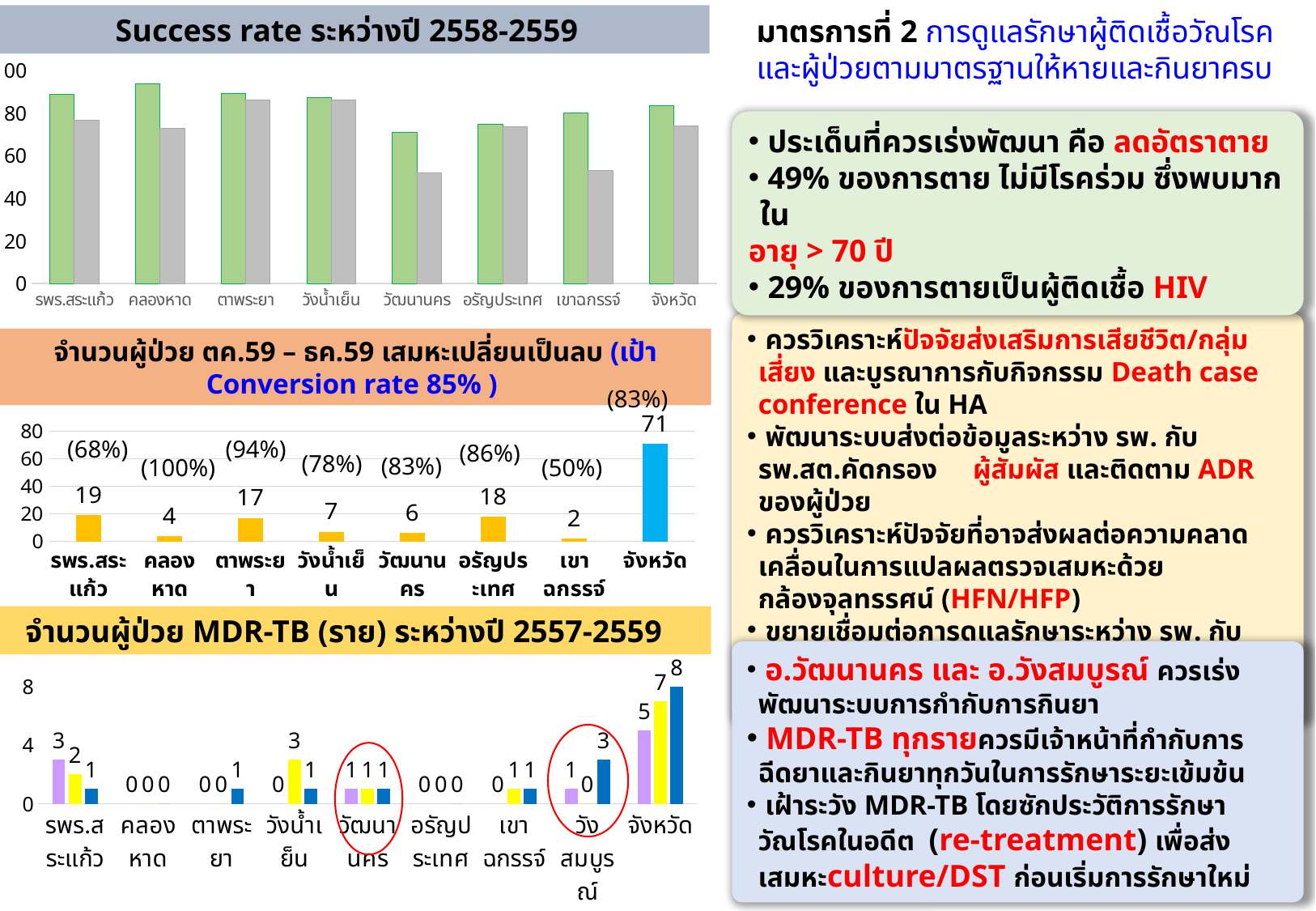
How many categories are shown on the x axis of the chart titled 'จำนวนผู้ป่วย MDR-TB (ราย) ระหว่างปี 2557-2559'? 9 In the chart titled 'จำนวนผู้ป่วย ตค.59 – ธค.59 เสมหะเปลี่ยนเป็นลบ', what is the value for ตาพระยา? 17 In the chart titled 'จำนวนผู้ป่วย ตค.59 – ธค.59 เสมหะเปลี่ยนเป็นลบ', what is the difference between the values for รพร.สระแก้ว and อรัญประเทศ? 1 In the chart titled 'จำนวนผู้ป่วย ตค.59 – ธค.59 เสมหะเปลี่ยนเป็นลบ', what percentage is shown above the bar for คลองหาด? 100% What kind of chart is the chart titled 'จำนวนผู้ป่วย MDR-TB (ราย) ระหว่างปี 2557-2559'? bar chart In the chart titled 'จำนวนผู้ป่วย MDR-TB (ราย) ระหว่างปี 2557-2559', what is the value of the blue bar for วังสมบูรณ์? 3 In the chart titled 'จำนวนผู้ป่วย ตค.59 – ธค.59 เสมหะเปลี่ยนเป็นลบ', which category has the highest value? จังหวัด In the chart titled 'Success rate ระหว่างปี 2558-2559', which bar is taller for คลองหาด, the green bar or the gray bar? the green bar In the chart titled 'จำนวนผู้ป่วย MDR-TB (ราย) ระหว่างปี 2557-2559', what is the value of the tallest bar for จังหวัด? 8 In the chart titled 'จำนวนผู้ป่วย ตค.59 – ธค.59 เสมหะเปลี่ยนเป็นลบ', which category has the lowest value? เขาฉกรรจ์ How many categories are shown on the x axis of the chart titled 'จำนวนผู้ป่วย ตค.59 – ธค.59 เสมหะเปลี่ยนเป็นลบ'? 8 In the chart titled 'Success rate ระหว่างปี 2558-2559', is the value of the gray bar for วัฒนานคร greater or less than 60? less